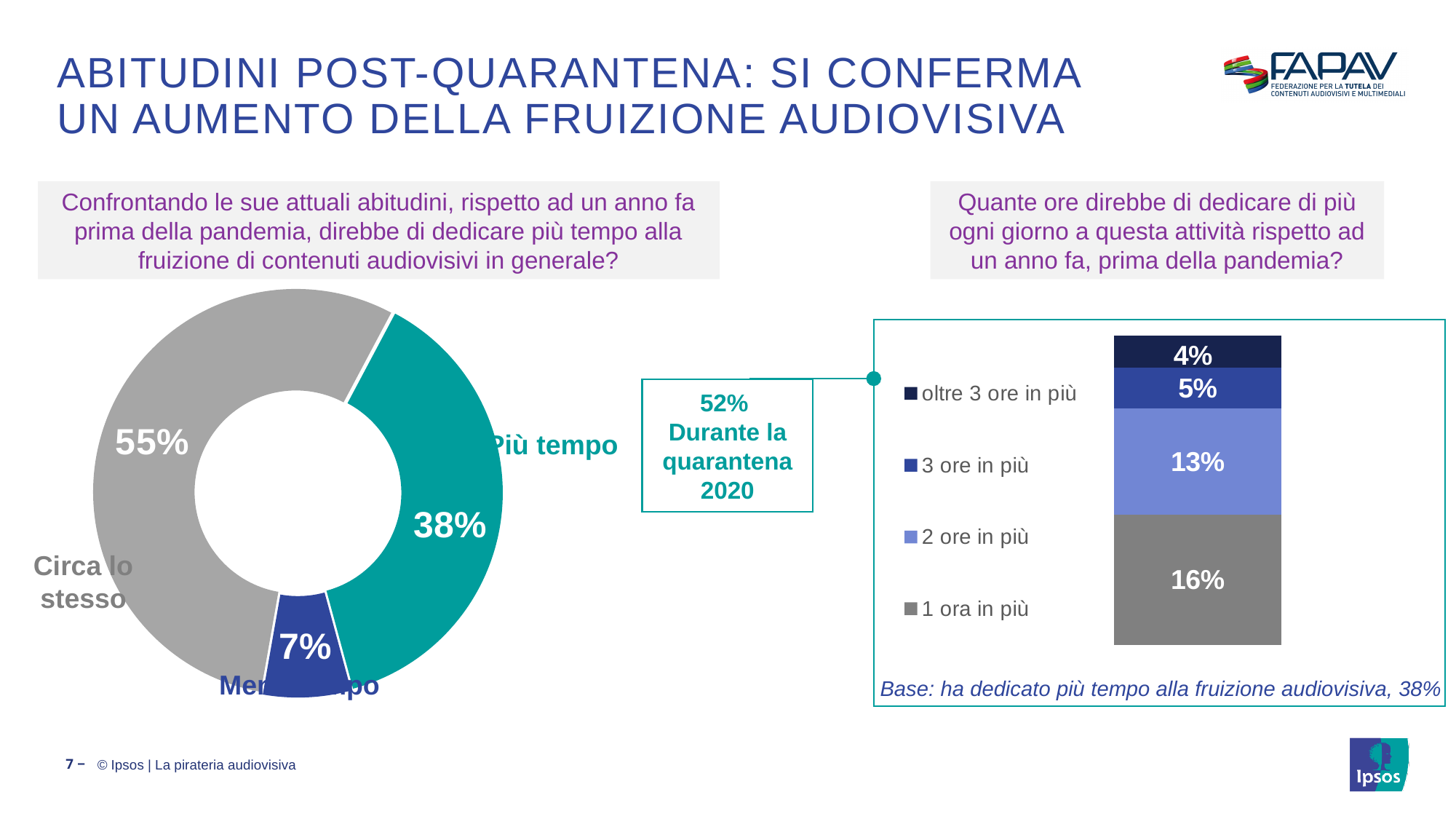
In the donut chart on the left, what percentage of respondents said 'Più tempo'? 38% In the stacked bar chart on the right, what is the value for '2 ore in più'? 13% In the stacked bar chart on the right, what is the total of all the segments? 38% In the donut chart on the left, what is the difference in percentage points between 'Circa lo stesso' and 'Più tempo'? 17 In the donut chart on the left, how many categories are shown? 3 In the donut chart on the left, which category has the smallest share? Meno tempo In the donut chart on the left, which category has the largest share? Circa lo stesso In the stacked bar chart on the right, which segment is the largest? 1 ora in più In the donut chart on the left, what percentage of respondents said 'Circa lo stesso'? 55% In the stacked bar chart on the right, which is larger: '3 ore in più' or '1 ora in più'? 1 ora in più In the stacked bar chart on the right, what is the value for 'oltre 3 ore in più'? 4% In the stacked bar chart on the right, how many entries does the legend list? 4